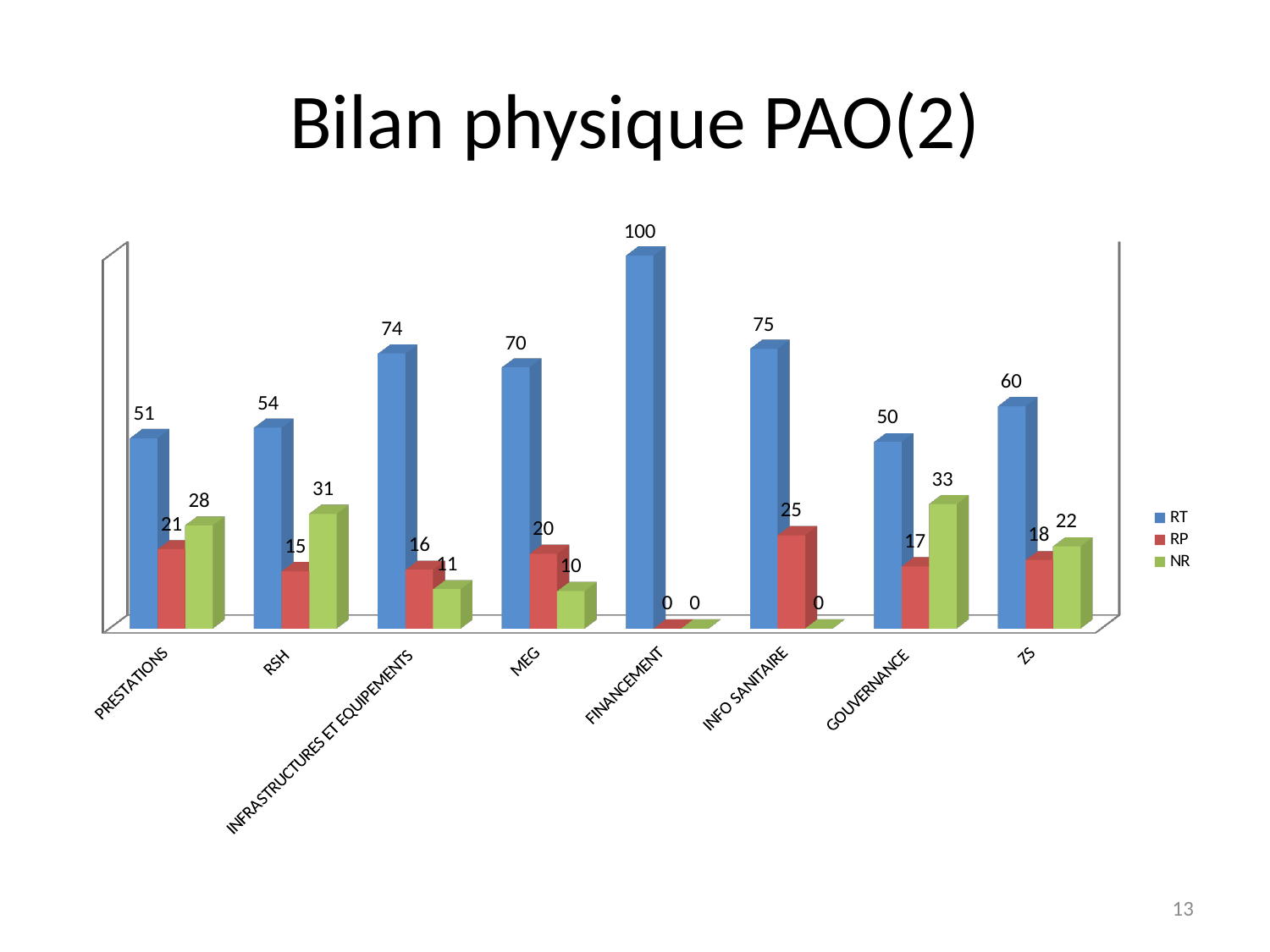
Which category has the lowest RT value? GOUVERNANCE What is the RT value for FINANCEMENT? 100 Which is larger, the NR value for RSH or the NR value for PRESTATIONS? RSH What is the RP value for RSH? 15 How many categories are shown on the x axis? 8 What is the difference between the RT values for INFO SANITAIRE and MEG? 5 How many series does the legend list? 3 What is the RP value for INFO SANITAIRE? 25 What kind of chart is shown on the slide? bar chart What is the title of the slide? Bilan physique PAO(2) What is the NR value for GOUVERNANCE? 33 Which category has the highest RT value? FINANCEMENT